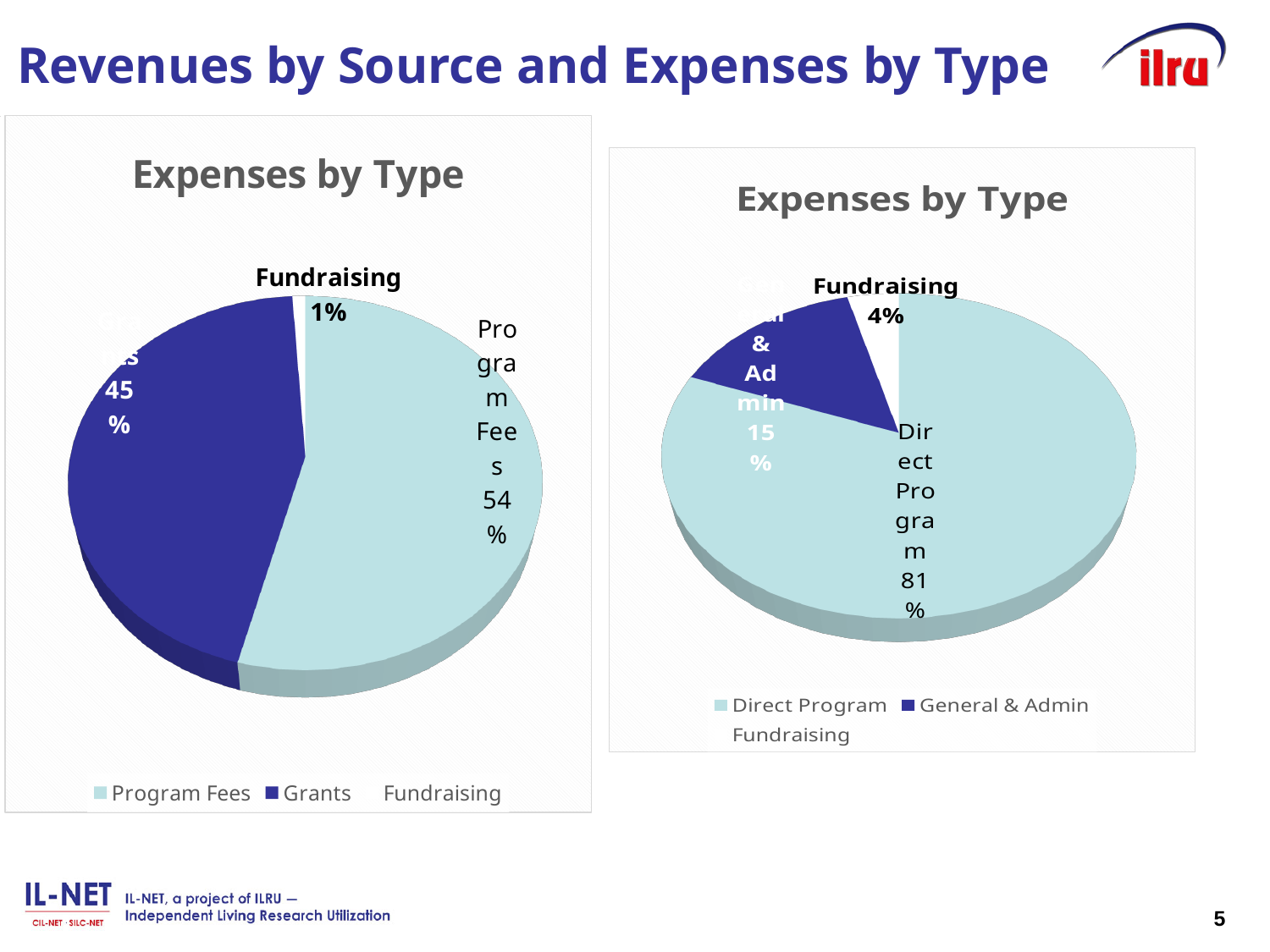
In the left pie chart, what share does Fundraising represent? 1% Which is larger in the right pie chart: the General & Admin share or the Fundraising share? General & Admin In the left pie chart, what is the difference between the Program Fees share and the Grants share? 9% In the left pie chart, which category has the largest slice? Program Fees In the right pie chart, which category has the largest slice? Direct Program In the right pie chart, what share does Direct Program represent? 81% In the left pie chart, what share do Grants represent? 45% In the right pie chart, what share does Fundraising represent? 4% How many categories does the legend of the right pie chart list? 3 What kind of chart is the left chart on the slide? pie chart In the left pie chart, which category has the smallest slice? Fundraising In the left pie chart, what share do Program Fees represent? 54%